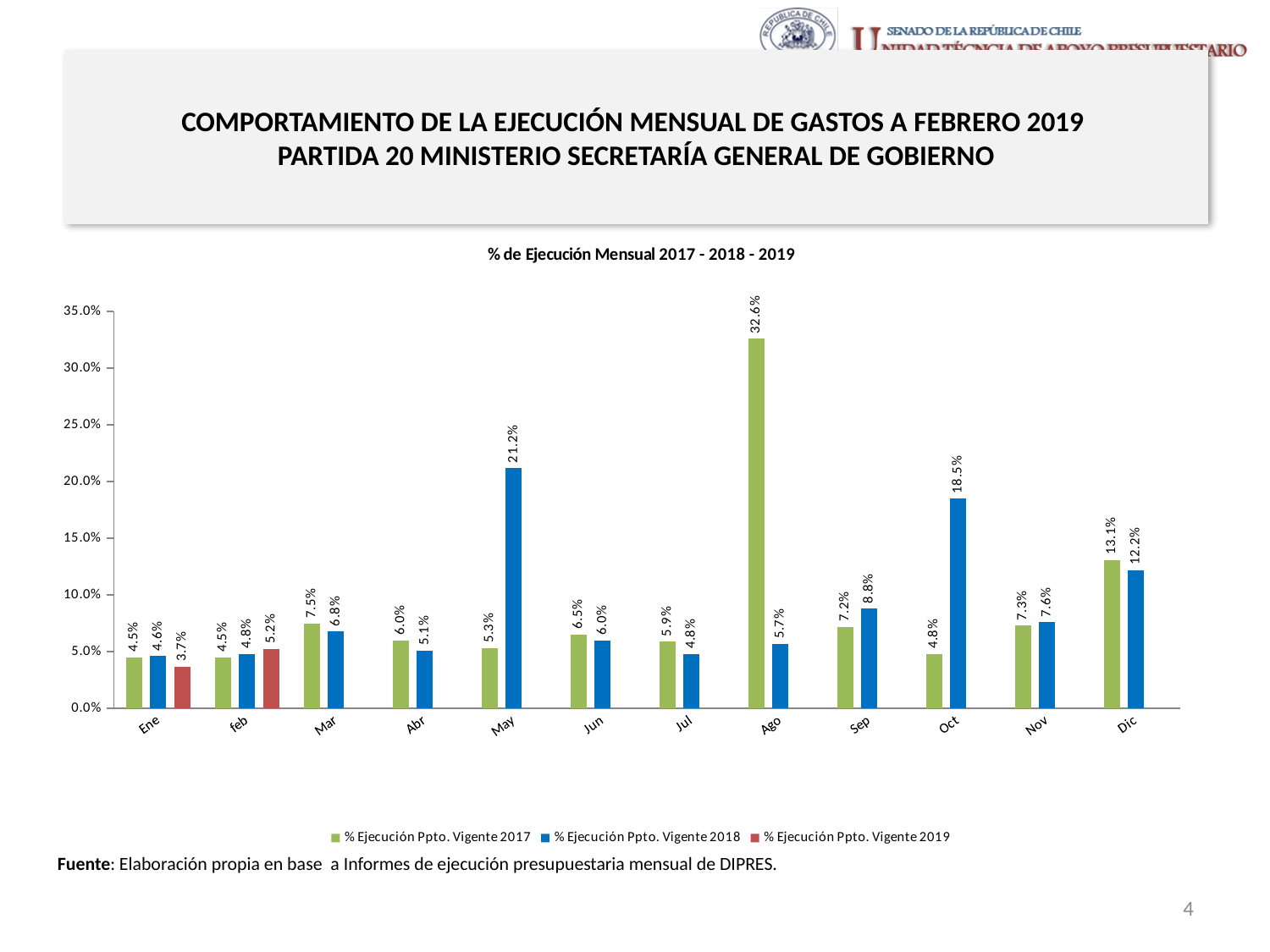
In which month is the % Ejecución Ppto. Vigente 2018 series lowest? Ene What is the title of the chart? % de Ejecución Mensual 2017 - 2018 - 2019 What is the difference between the 2018 and 2017 values in Oct? 13.7% What is the value for % Ejecución Ppto. Vigente 2018 in May? 21.2% In which month is the % Ejecución Ppto. Vigente 2017 series highest? Ago Which is larger in feb: the 2019 value or the 2017 value? 2019 value (5.2%) How many months are shown on the x axis? 12 What is the value for % Ejecución Ppto. Vigente 2019 in Ene? 3.7% What is the value for % Ejecución Ppto. Vigente 2017 in Dic? 13.1% Is the value for % Ejecución Ppto. Vigente 2017 in Ago greater or less than 30.0%? greater What kind of chart is shown on the slide? Bar chart How many series does the legend list? 3